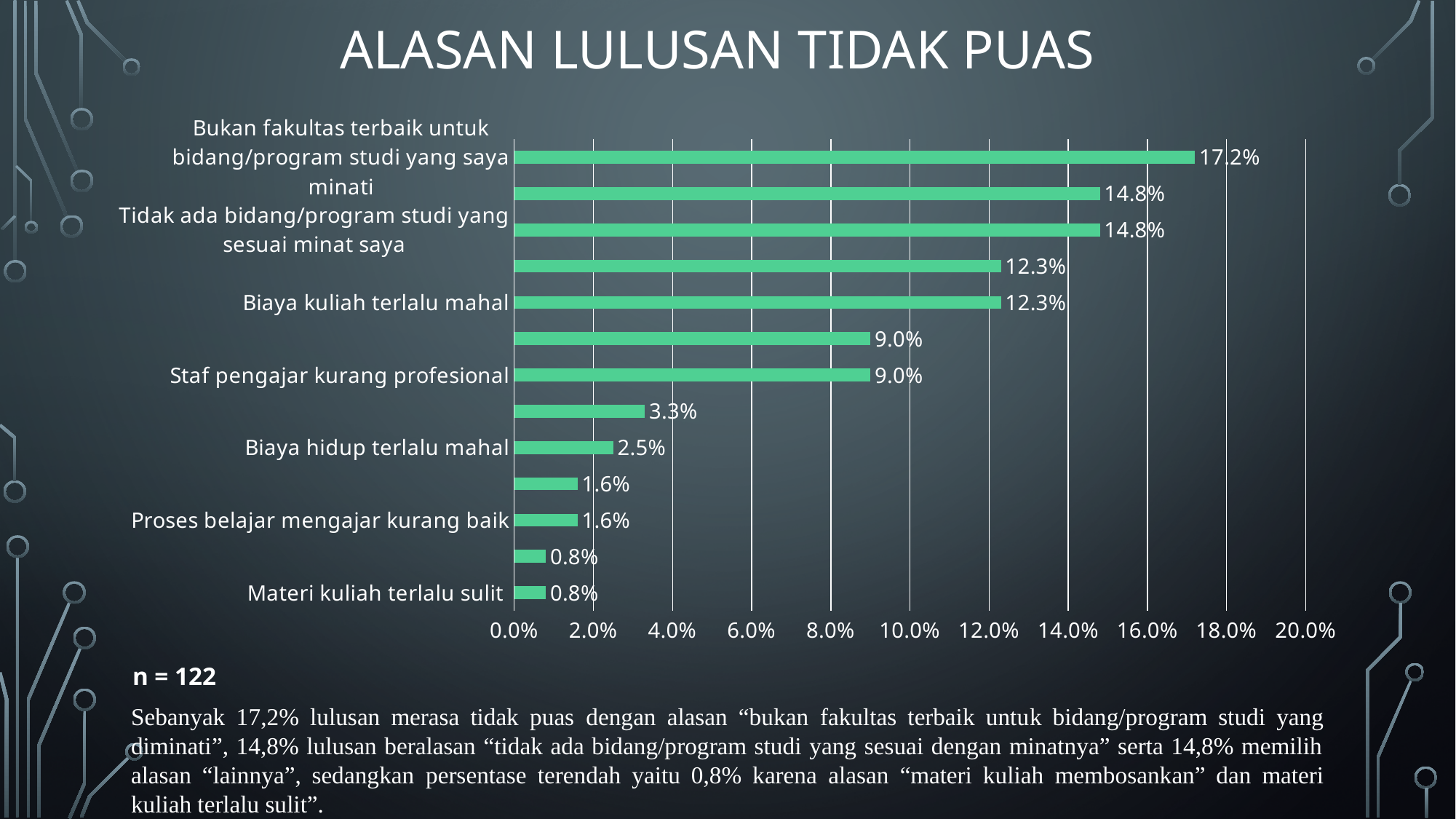
What is the value for "Bukan fakultas terbaik untuk bidang/program studi yang saya minati"? 17.2% Which is larger: the value for "Biaya kuliah terlalu mahal" or "Biaya hidup terlalu mahal"? Biaya kuliah terlalu mahal Which category has the highest value? Bukan fakultas terbaik untuk bidang/program studi yang saya minati What is the value for "Staf pengajar kurang profesional"? 9.0% What is the value for "Biaya hidup terlalu mahal"? 2.5% What is the difference between the values for "Bukan fakultas terbaik untuk bidang/program studi yang saya minati" and "Tidak ada bidang/program studi yang sesuai minat saya"? 2.4% What is the value for "Tidak ada bidang/program studi yang sesuai minat saya"? 14.8% What is the lowest value shown in the chart? 0.8% What is the value for "Materi kuliah terlalu sulit"? 0.8% How many bars are plotted in the chart? 13 What type of chart is shown on the slide? bar chart What is the value for "Biaya kuliah terlalu mahal"? 12.3%